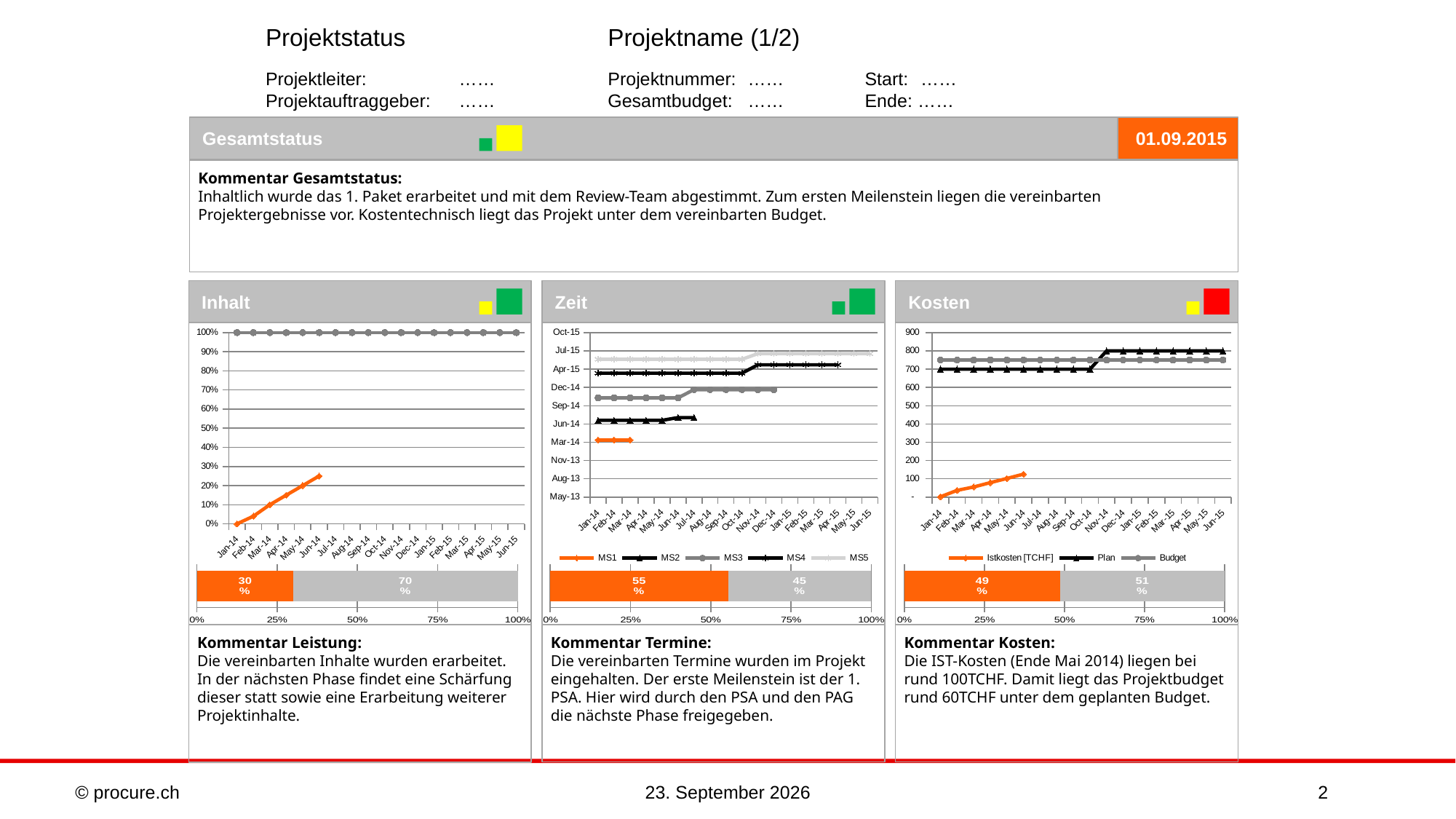
How many months are labelled on the x axis of the Kosten line chart? 18 How many series does the legend of the Kosten line chart list? 3 In the Zeit panel, what percentage does the orange segment of the progress bar show? 55% In the Kosten panel, what is the total of the two segments of the progress bar (49% and 51%)? 100% In the Kosten line chart, is the Budget value at Jan-14 greater or less than 500? greater In the Kosten line chart, does the Istkosten [TCHF] series rise or fall from Jan-14 to Jun-14? rise In the Zeit line chart, which series lies highest on the chart? MS5 In the Inhalt panel, what percentage does the grey segment of the progress bar show? 70% In the Kosten line chart, is the Istkosten [TCHF] value at Jun-14 greater or less than 300? less How many series does the legend of the Zeit line chart list? 5 In the Inhalt panel, what percentage does the orange segment of the progress bar show? 30% In the Kosten panel, what is the difference between the grey segment (51%) and the orange segment (49%) of the progress bar? 2%